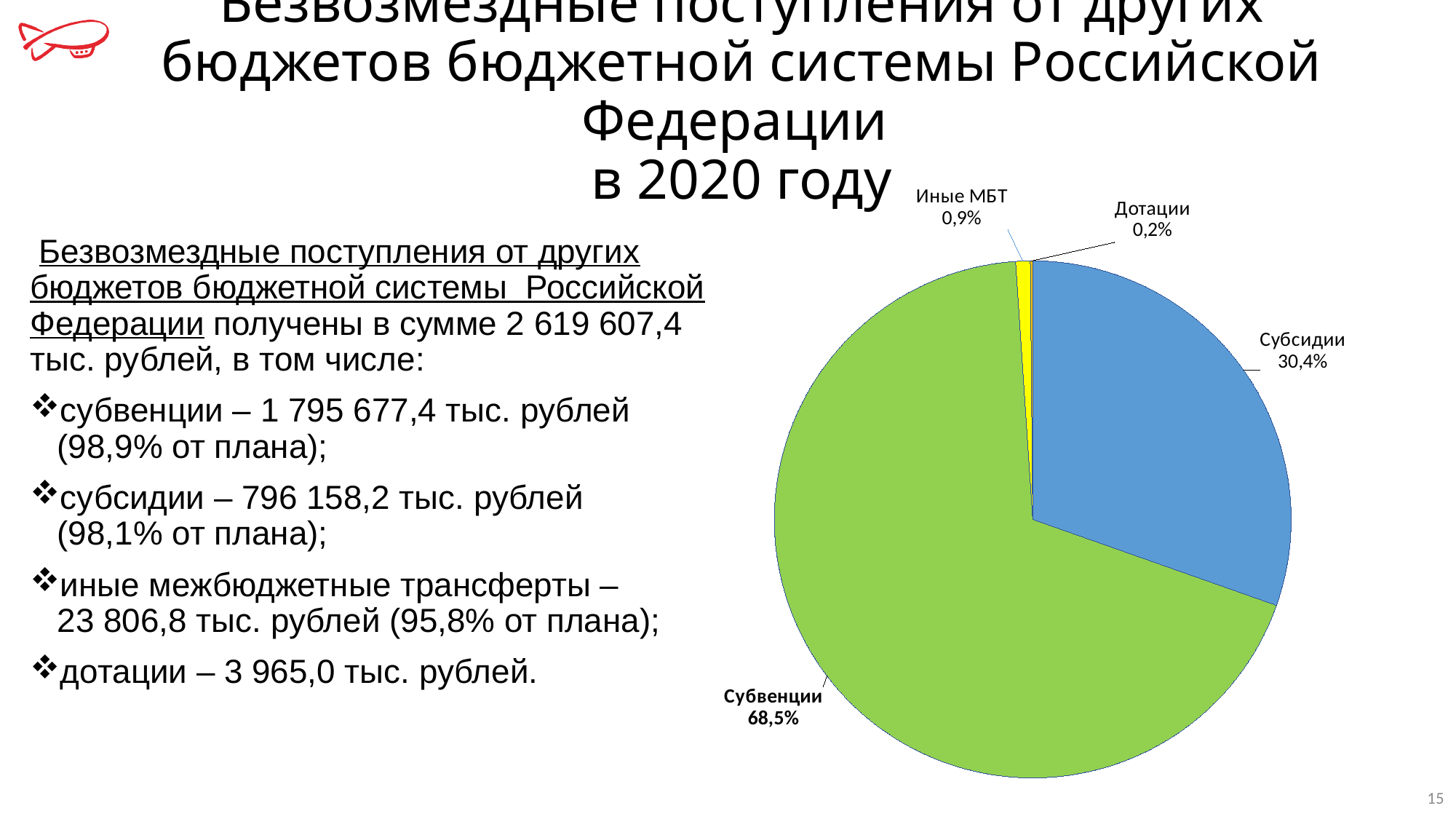
What colour is the Субсидии slice in the pie chart? blue Which is larger in the pie chart, Иные МБТ or Дотации? Иные МБТ Which slice of the pie chart is the smallest? Дотации What is the difference in percentage points between Субвенции and Субсидии? 38,1 What colour is the Субвенции slice in the pie chart? green Which slice of the pie chart is the largest? Субвенции What is the value shown for Дотации in the pie chart? 0,2% How many slices does the pie chart have? 4 What share of the pie does Субвенции take? 68,5% What kind of chart is shown on the slide? pie chart What is the value shown for Иные МБТ in the pie chart? 0,9% What share of the pie does Субсидии take? 30,4%